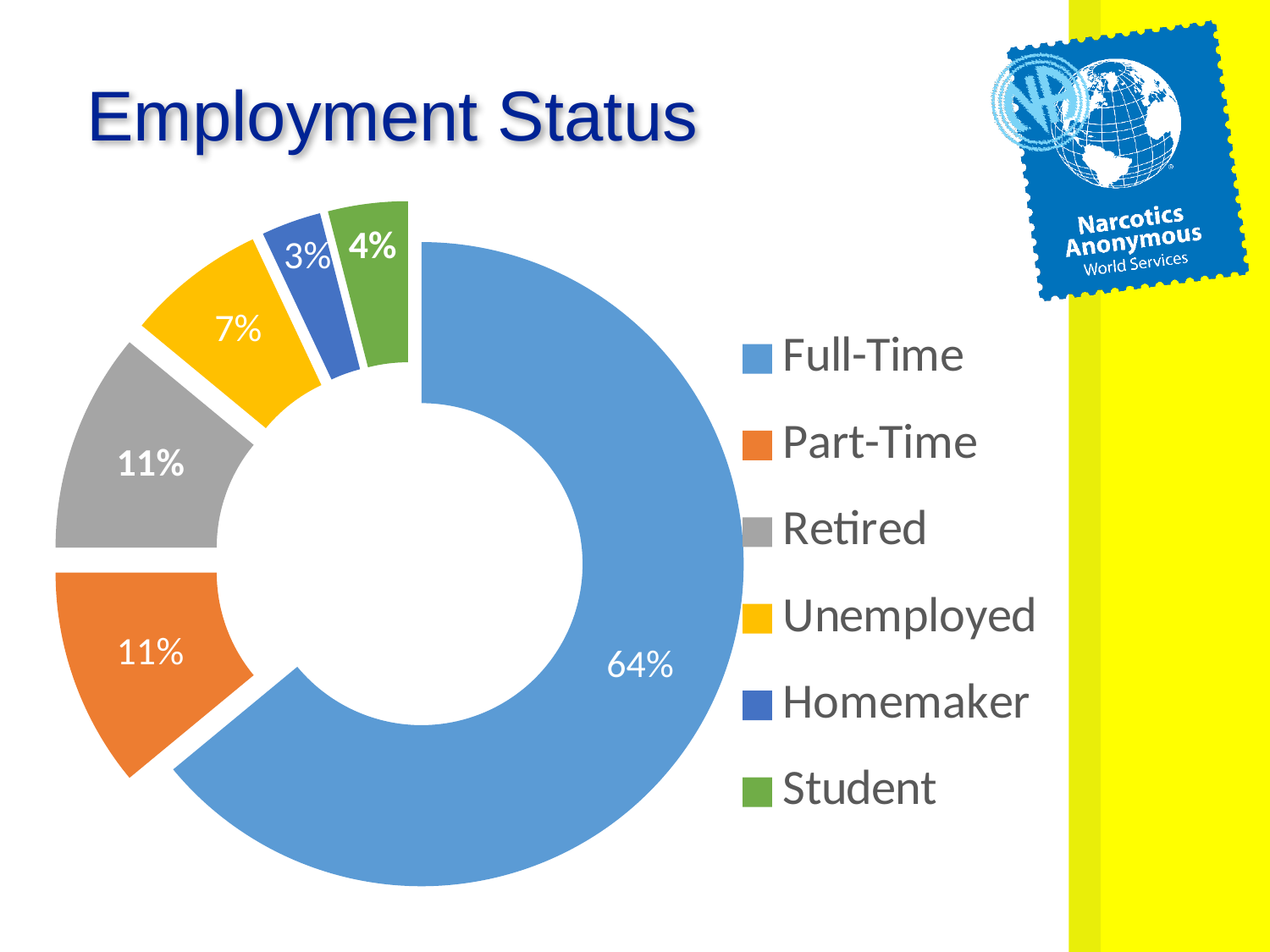
What kind of chart is shown on the slide? Doughnut (pie) chart Which category has the smallest share? Homemaker What is the value for Part-Time? 11% What is the value for Student? 4% How many categories does the chart show? 6 What is the value for Homemaker? 3% Which category has the largest share? Full-Time Which is larger, Unemployed or Student? Unemployed What is the difference between the Full-Time and Part-Time shares? 53% What share of the pie does Full-Time represent? 64% What is the value for Unemployed? 7% What is the value for Retired? 11%